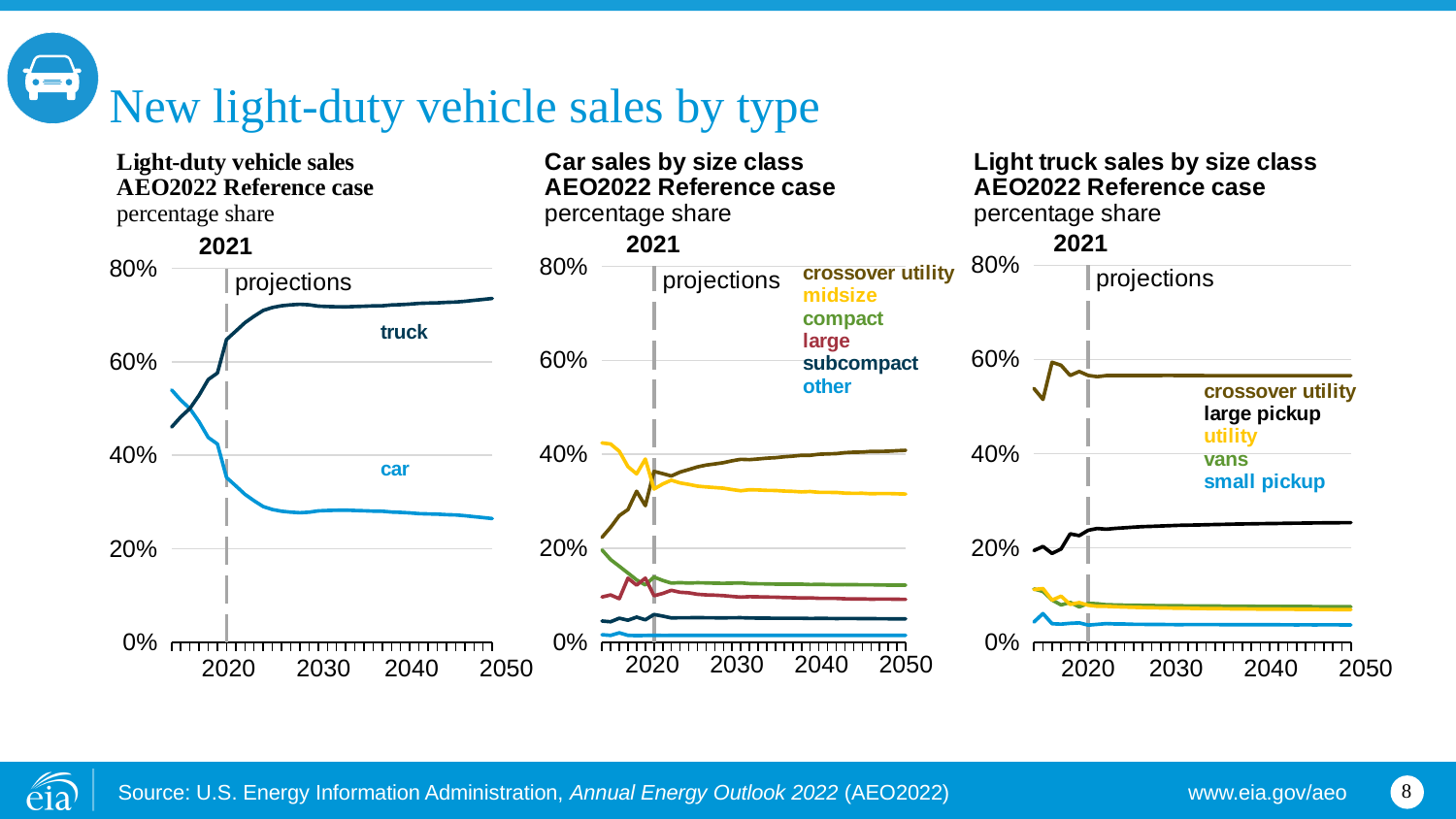
In the "Car sales by size class" chart, how many size classes are listed in the legend? 6 In the "Car sales by size class" chart, which size class has the highest share in 2050? crossover utility In the "Light-duty vehicle sales" chart, is the truck share in 2050 greater or less than 60%? greater What kind of chart is the "Light-duty vehicle sales" chart on the left? line chart In the "Light-duty vehicle sales" chart, does the car share rise or fall from 2020 to 2050? fall In the "Car sales by size class" chart, is the midsize share in 2050 greater or less than 40%? less How many charts are shown on the slide? 3 In the "Light-duty vehicle sales" chart, which series has the larger share in 2050, truck or car? truck In the "Light truck sales by size class" chart, is the large pickup share in 2050 greater or less than 20%? greater In the "Light truck sales by size class" chart, which size class has the lowest share in 2050? small pickup In the "Light-duty vehicle sales" chart, how many series are plotted? 2 In the "Light-duty vehicle sales" chart, does the truck share rise or fall over the projection period? rise